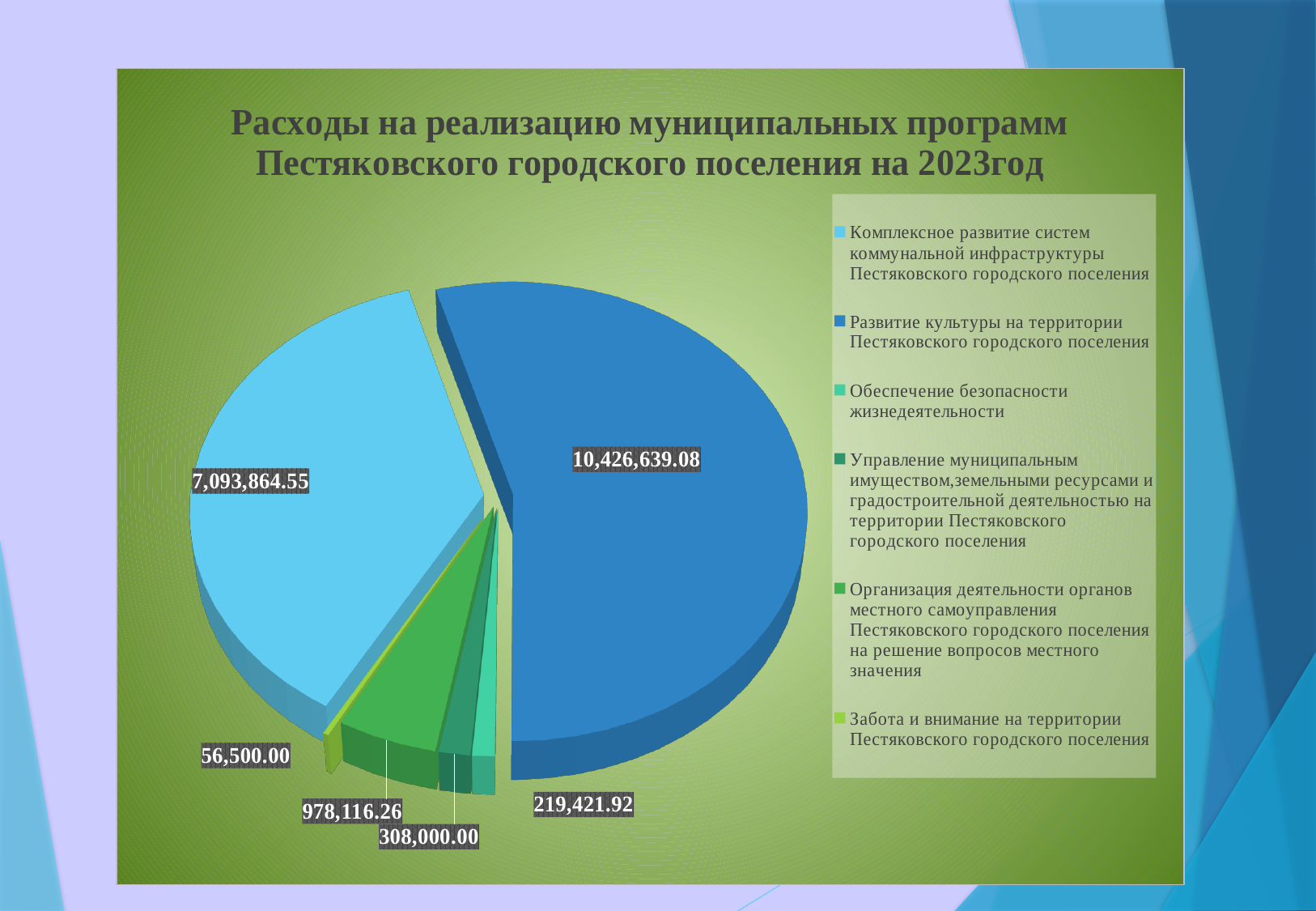
Which is larger: the value for «Организация деятельности органов местного самоуправления» or the value for «Обеспечение безопасности жизнедеятельности»? Организация деятельности органов местного самоуправления What year does the chart title refer to? 2023 What is the value for «Забота и внимание на территории Пестяковского городского поселения»? 56,500.00 How many entries does the legend list? 6 What is the value for «Развитие культуры на территории Пестяковского городского поселения»? 10,426,639.08 How many slices does the pie chart have? 6 What is the value for «Организация деятельности органов местного самоуправления Пестяковского городского поселения на решение вопросов местного значения»? 978,116.26 What kind of chart is shown on the slide? pie chart What is the difference between the values for «Развитие культуры» and «Комплексное развитие систем коммунальной инфраструктуры»? 3,332,774.53 Which category has the largest slice of the pie? Развитие культуры на территории Пестяковского городского поселения Which category has the smallest slice of the pie? Забота и внимание на территории Пестяковского городского поселения What is the value for «Комплексное развитие систем коммунальной инфраструктуры Пестяковского городского поселения»? 7,093,864.55